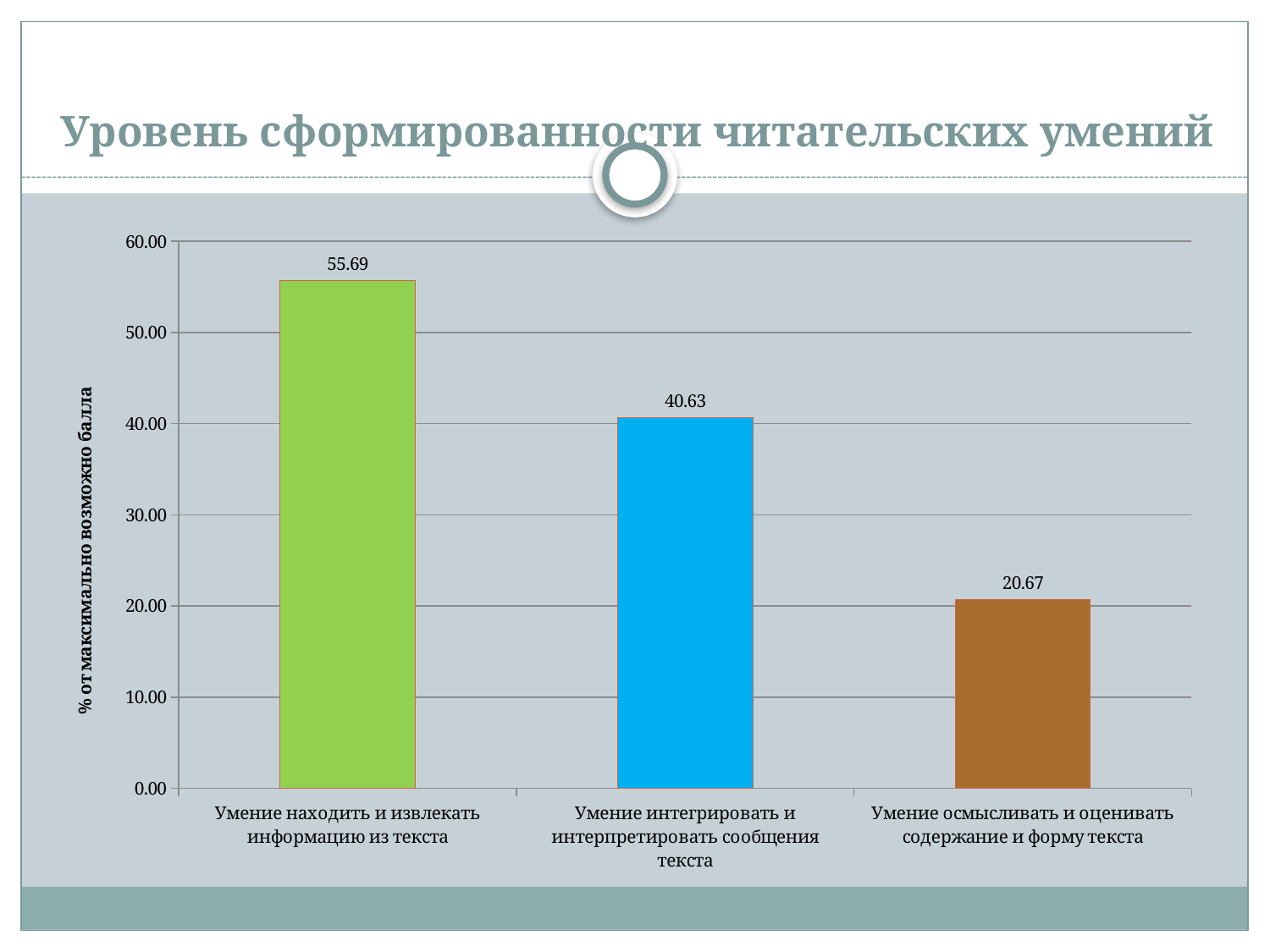
Which category has the highest value? Умение находить и извлекать информацию из текста Do the values rise or fall from left to right across the categories? Fall What is the difference between the values for "Умение находить и извлекать информацию из текста" and "Умение интегрировать и интерпретировать сообщения текста"? 15.06 Which is larger: the value for "Умение интегрировать и интерпретировать сообщения текста" or for "Умение осмысливать и оценивать содержание и форму текста"? Умение интегрировать и интерпретировать сообщения текста What kind of chart is shown on the slide? Bar chart How many categories are shown in the chart? 3 What is the difference between the values for "Умение интегрировать и интерпретировать сообщения текста" and "Умение осмысливать и оценивать содержание и форму текста"? 19.96 What is the value for "Умение интегрировать и интерпретировать сообщения текста"? 40.63 What is the value for "Умение находить и извлекать информацию из текста"? 55.69 What is the value for "Умение осмысливать и оценивать содержание и форму текста"? 20.67 Is the value for "Умение интегрировать и интерпретировать сообщения текста" greater or less than 50.00? less Which category has the lowest value? Умение осмысливать и оценивать содержание и форму текста